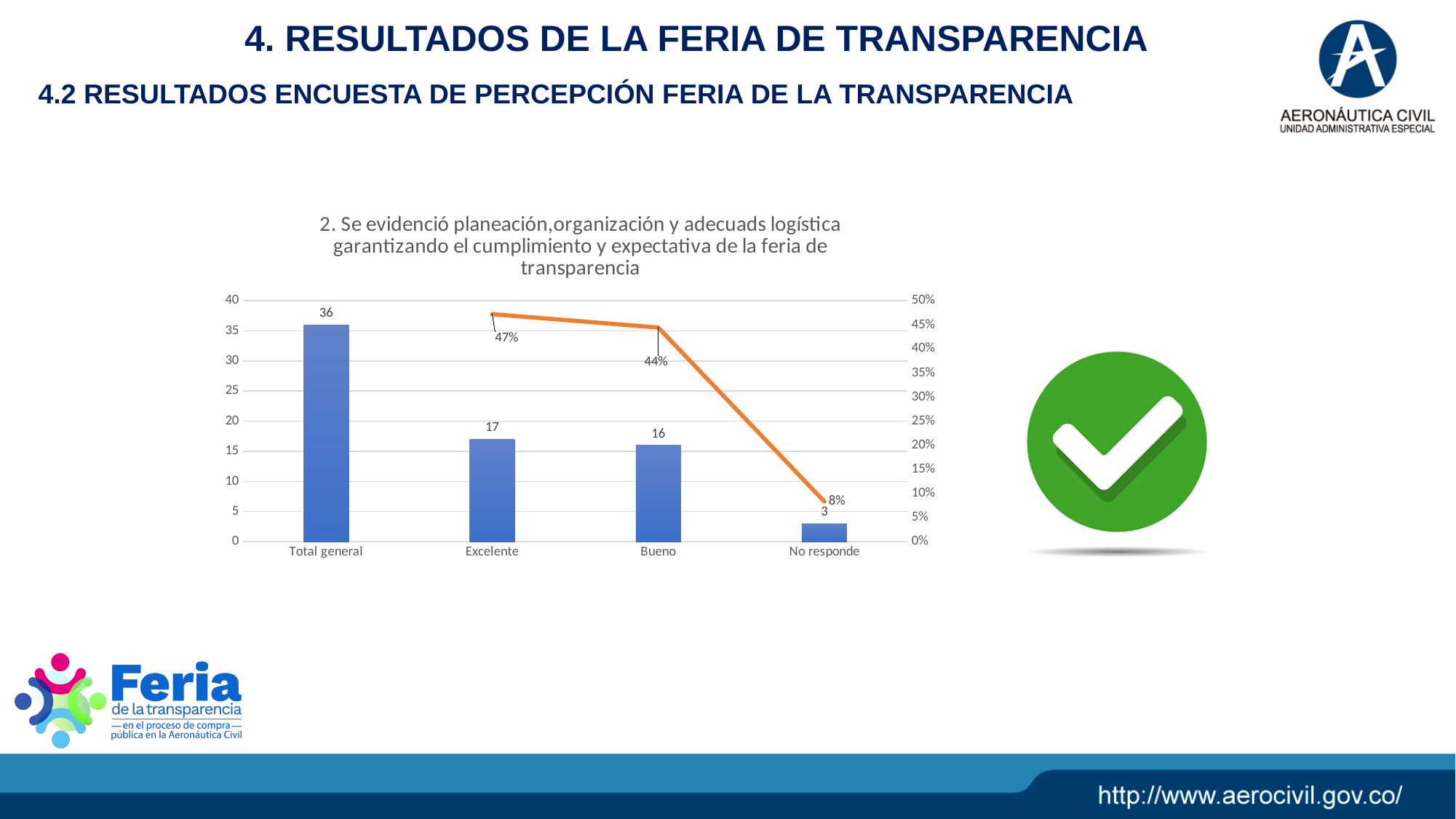
What is the difference between the bar values for Excelente and Bueno? 1 Is the bar value for Total general greater or less than 30? greater What percentage is shown on the line for Excelente? 47% What is the bar value for Total general? 36 What is the difference between the line percentages for Excelente and Bueno? 3% What percentage is shown on the line for No responde? 8% Which category has the lowest bar value? No responde How many categories are shown on the x axis? 4 What is the bar value for Bueno? 16 Which category has the highest bar value? Total general What is the bar value for No responde? 3 What is the bar value for Excelente? 17